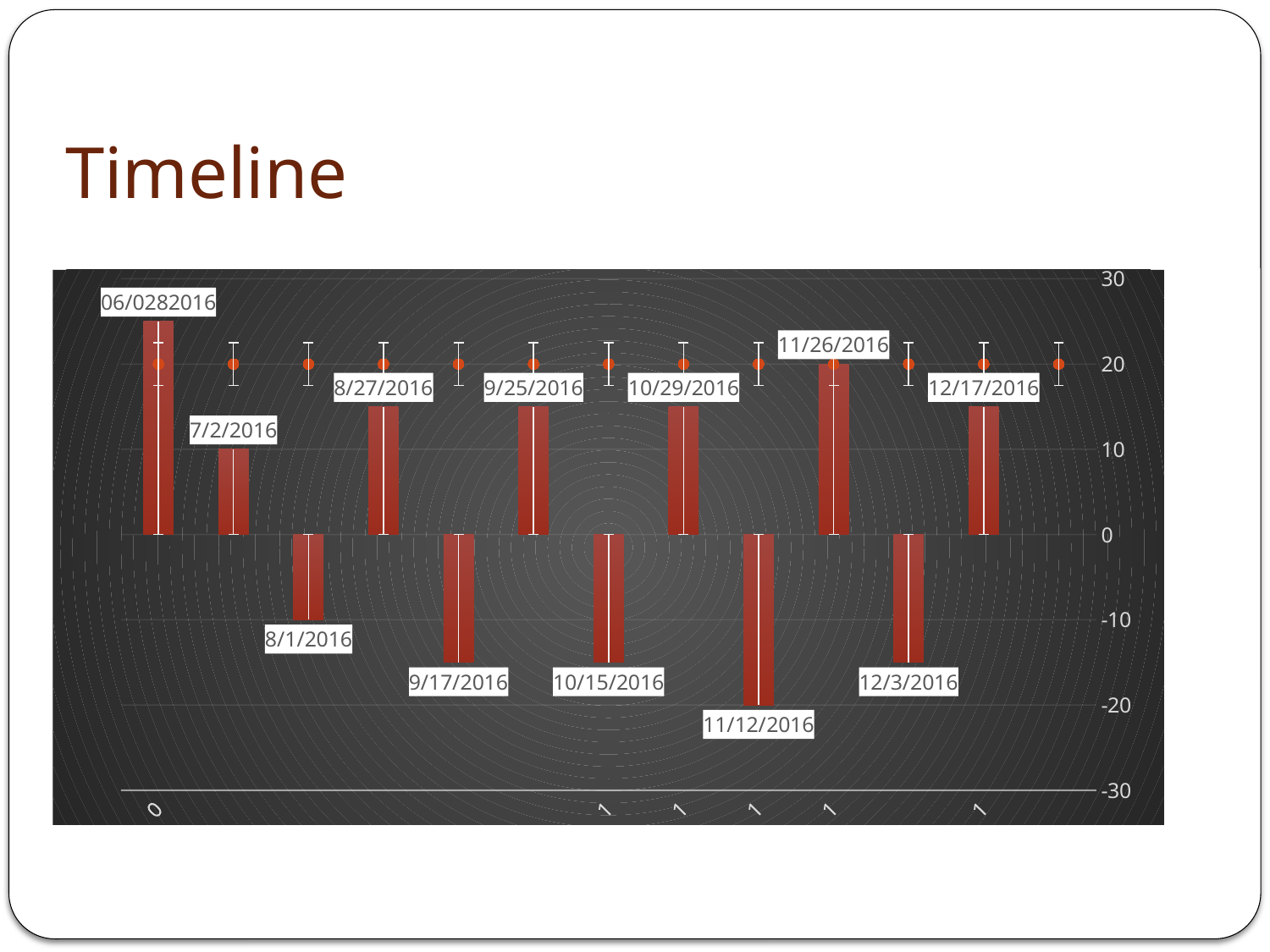
What is the title of the slide containing the chart? Timeline Which has the larger value, 06/0282016 or 7/2/2016? 06/0282016 Is the value for 8/27/2016 greater or less than 20? less What kind of chart is shown on the slide? combination bar and line chart Which bar reaches the highest value in the chart? 06/0282016 How many bars are plotted in the chart? 12 Is the value for 7/2/2016 greater or less than 20? less How many bars extend below zero in the chart? 5 Which bar reaches the lowest value in the chart? 11/12/2016 Is the value for 06/0282016 greater or less than 20? greater